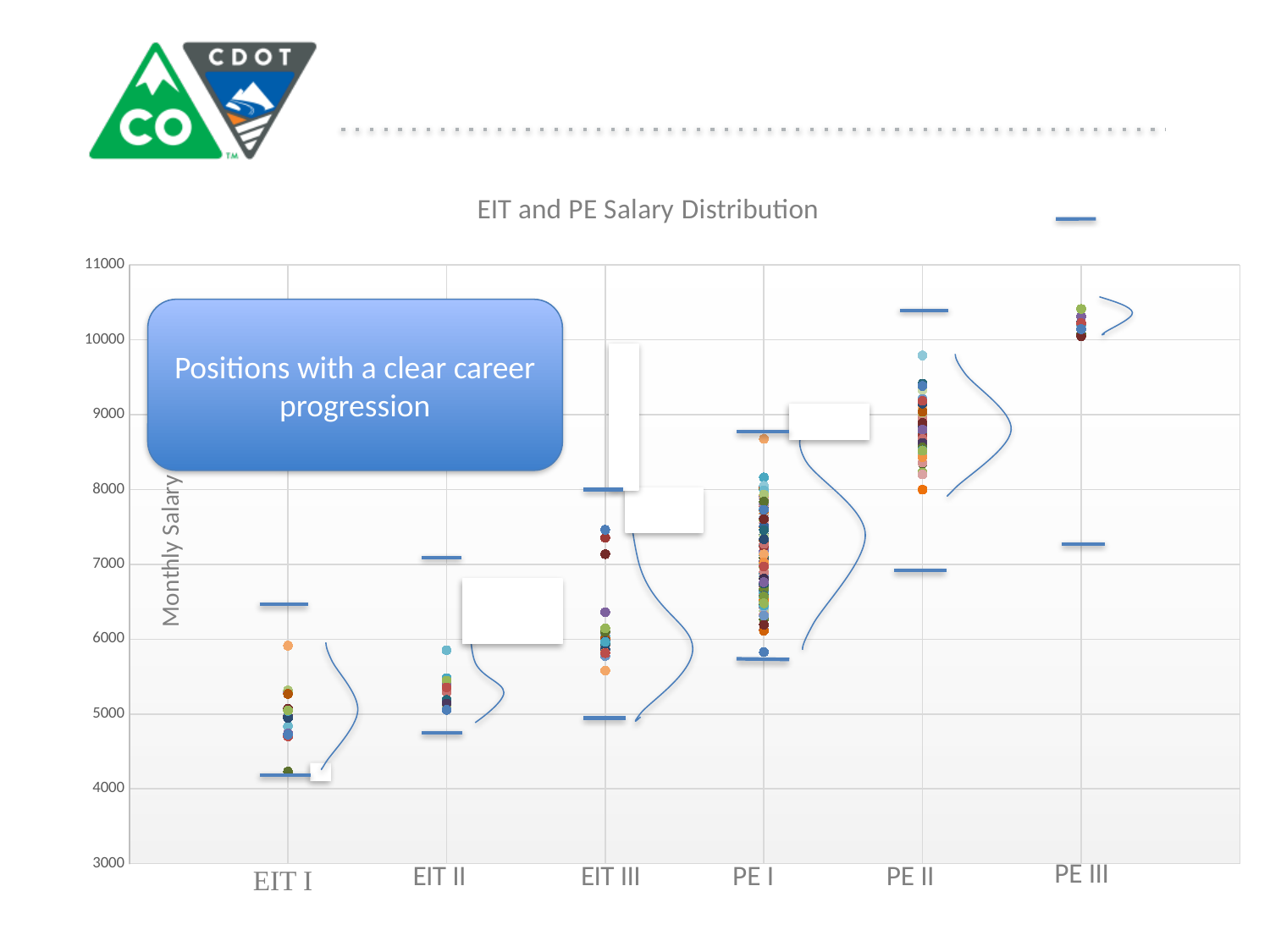
How many position categories are shown along the x axis of the chart? 6 Are the plotted salary values for PE III greater or less than 9000? greater Are the plotted salary values for PE II greater or less than 7000? greater Which category has the highest plotted salary values, EIT I or PE III? PE III Are the plotted salary values for EIT I greater or less than 7000? less Do the plotted salary values generally rise or fall moving from EIT I to PE III along the x axis? Rise What is the title of the chart? EIT and PE Salary Distribution What is the maximum value shown on the vertical axis of the chart? 11000 Which category has the lowest plotted salary values on the chart? EIT I What is the label of the vertical axis of the chart? Monthly Salary What kind of chart is shown on the slide? Scatter chart